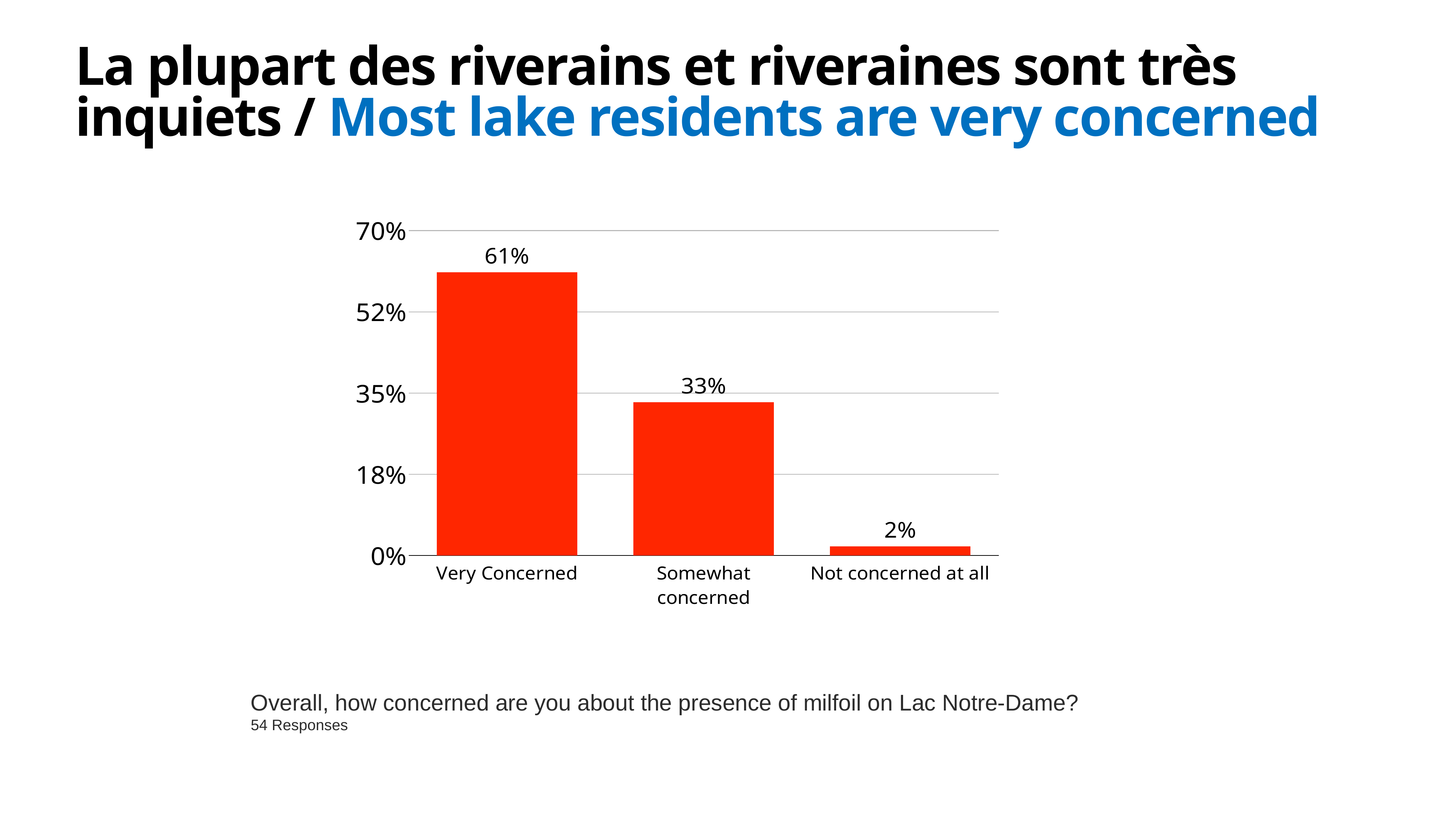
What percentage of respondents are Very Concerned? 61% What is the difference between the Somewhat concerned and Not concerned at all values? 31% Which is larger, the value for Very Concerned or the value for Somewhat concerned? Very Concerned What percentage of respondents are Somewhat concerned? 33% What percentage of respondents are Not concerned at all? 2% Is the value for Very Concerned greater or less than 52%? greater What is the difference between the Very Concerned and Somewhat concerned values? 28% Which category has the lowest value? Not concerned at all What kind of chart is shown on the slide? bar chart How many categories are shown on the x axis? 3 Do the values rise or fall from left to right along the x axis? fall Which category has the highest value? Very Concerned